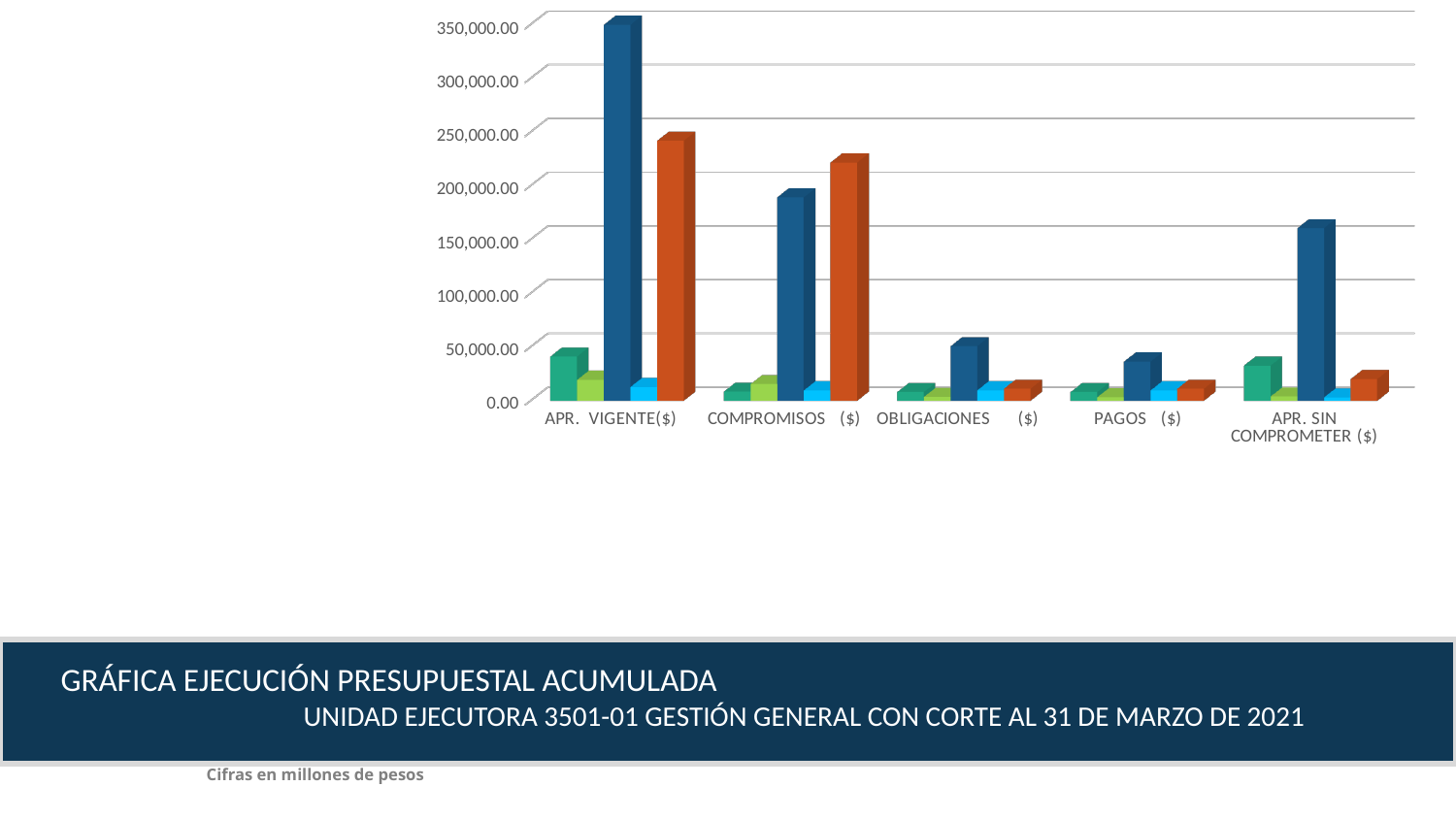
Is the dark blue bar for APR. VIGENTE($) greater or less than 300,000.00? greater What kind of chart is shown on the slide? bar chart Is the dark blue bar for APR. SIN COMPROMETER ($) greater or less than 100,000.00? greater How many categories are shown on the x axis of the chart? 5 Is the dark blue bar for PAGOS ($) greater or less than 50,000.00? less Which category has the shortest dark blue bar? PAGOS ($) Which has the larger dark blue bar, APR. VIGENTE($) or COMPROMISOS ($)? APR. VIGENTE($) Which category has the tallest bar in the chart? APR. VIGENTE($) Which has the larger dark blue bar, OBLIGACIONES ($) or PAGOS ($)? OBLIGACIONES ($) According to the note below the chart, in what units are the figures expressed? millones de pesos